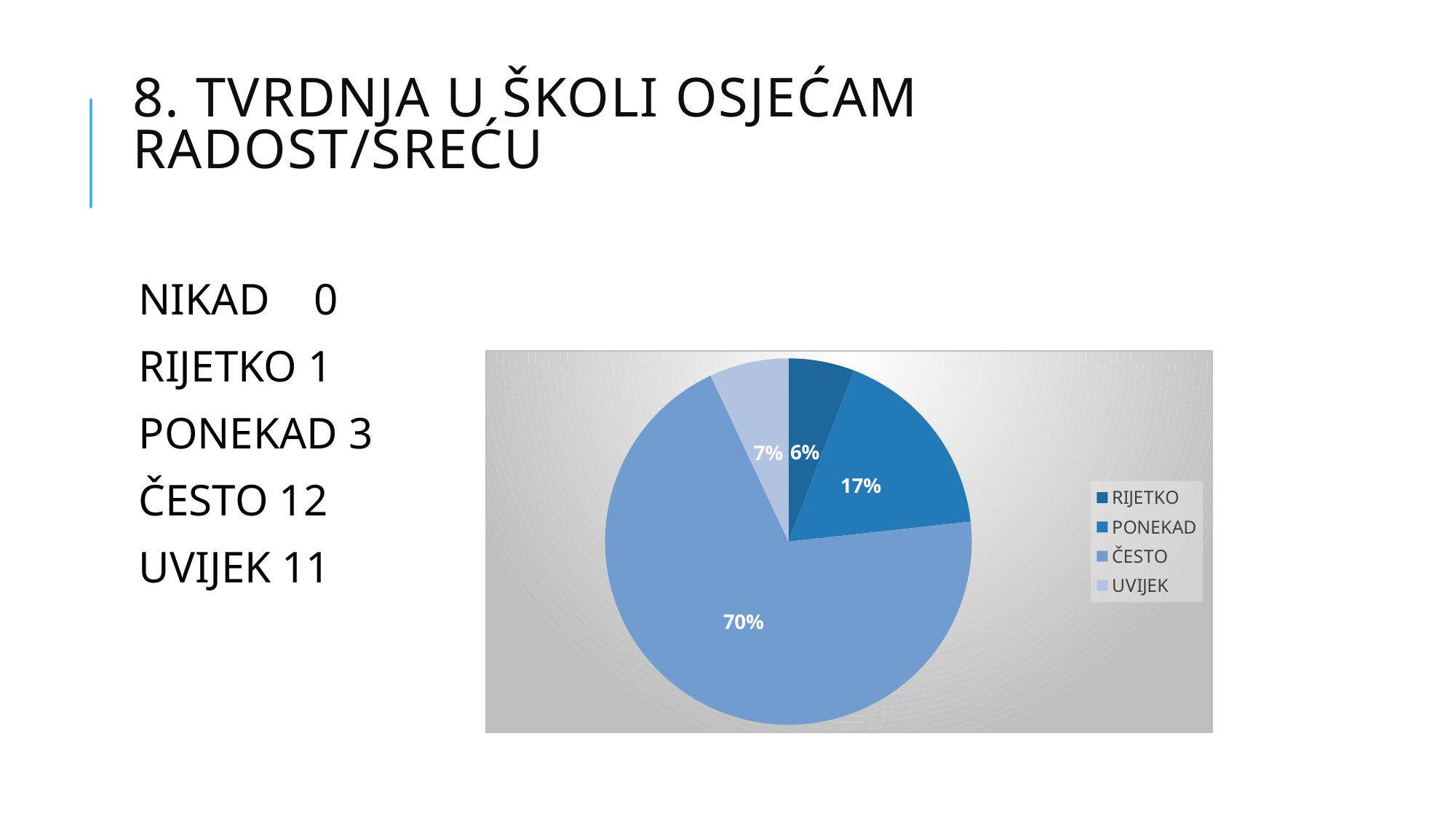
What is the difference in percentage points between the ČESTO slice and the PONEKAD slice? 53 How many entries does the legend of the pie chart list? 4 Which slice is larger in the pie chart, PONEKAD or UVIJEK? PONEKAD What percentage does the PONEKAD slice show in the pie chart? 17% Which legend entry is shown with the lightest blue colour in the pie chart? UVIJEK What percentage does the UVIJEK slice show in the pie chart? 7% What kind of chart is shown on the slide? pie chart How many slices does the pie chart have? 4 What percentage does the ČESTO slice show in the pie chart? 70% Which category has the smallest slice in the pie chart? RIJETKO What percentage does the RIJETKO slice show in the pie chart? 6% Which category has the largest slice in the pie chart? ČESTO